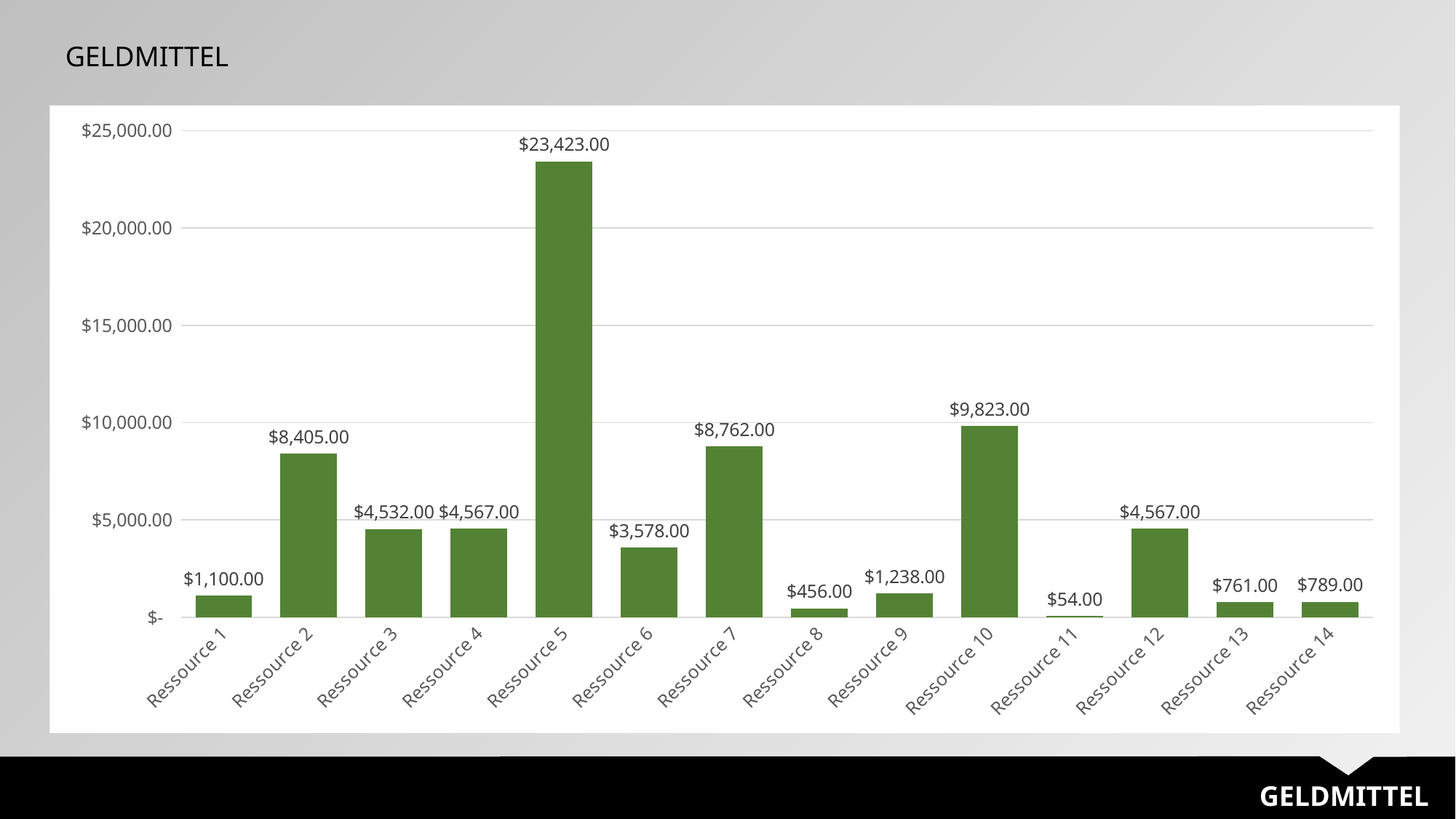
How many categories are shown on the x axis? 14 Is the value for Ressource 6 greater or less than $5,000.00? less What is the title of the chart? GELDMITTEL What is the value for Ressource 5? $23,423.00 What is the value for Ressource 10? $9,823.00 What is the value for Ressource 11? $54.00 What is the difference between the values for Ressource 2 and Ressource 7? $357.00 Which is larger, the value for Ressource 13 or the value for Ressource 14? Ressource 14 What is the difference between the values for Ressource 5 and Ressource 10? $13,600.00 Which category has the lowest value? Ressource 11 Which category has the highest value? Ressource 5 What kind of chart is shown on the slide? bar chart